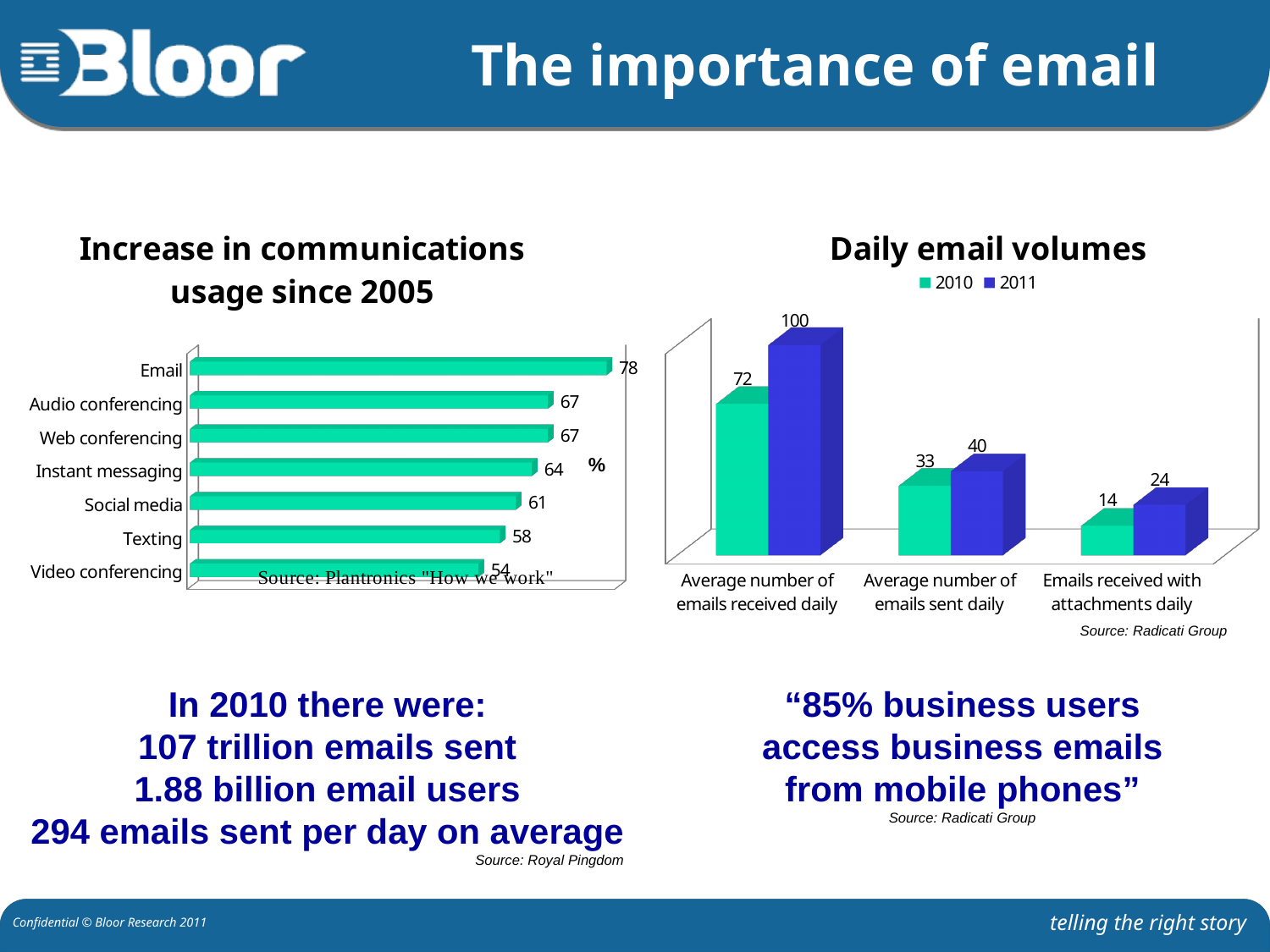
In the 'Increase in communications usage since 2005' chart, how many categories are shown? 7 In the 'Daily email volumes' chart, which colour represents 2011? Blue In the 'Increase in communications usage since 2005' chart, what is the value for Email? 78 In the 'Daily email volumes' chart, what is the 2010 value for Emails received with attachments daily? 14 In the 'Daily email volumes' chart, how many series does the legend list? 2 In the 'Daily email volumes' chart, which is larger: the 2010 value for Average number of emails received daily or the 2011 value for Average number of emails sent daily? 2010 Average number of emails received daily In the 'Daily email volumes' chart, what is the difference between the 2011 and 2010 values for Average number of emails sent daily? 7 In the 'Increase in communications usage since 2005' chart, which category has the lowest value? Video conferencing In the 'Increase in communications usage since 2005' chart, what is the difference between Email and Texting? 20 In the 'Daily email volumes' chart, what is the 2011 value for Average number of emails received daily? 100 What kind of chart is the 'Daily email volumes' chart? Bar chart In the 'Increase in communications usage since 2005' chart, what is the value for Social media? 61